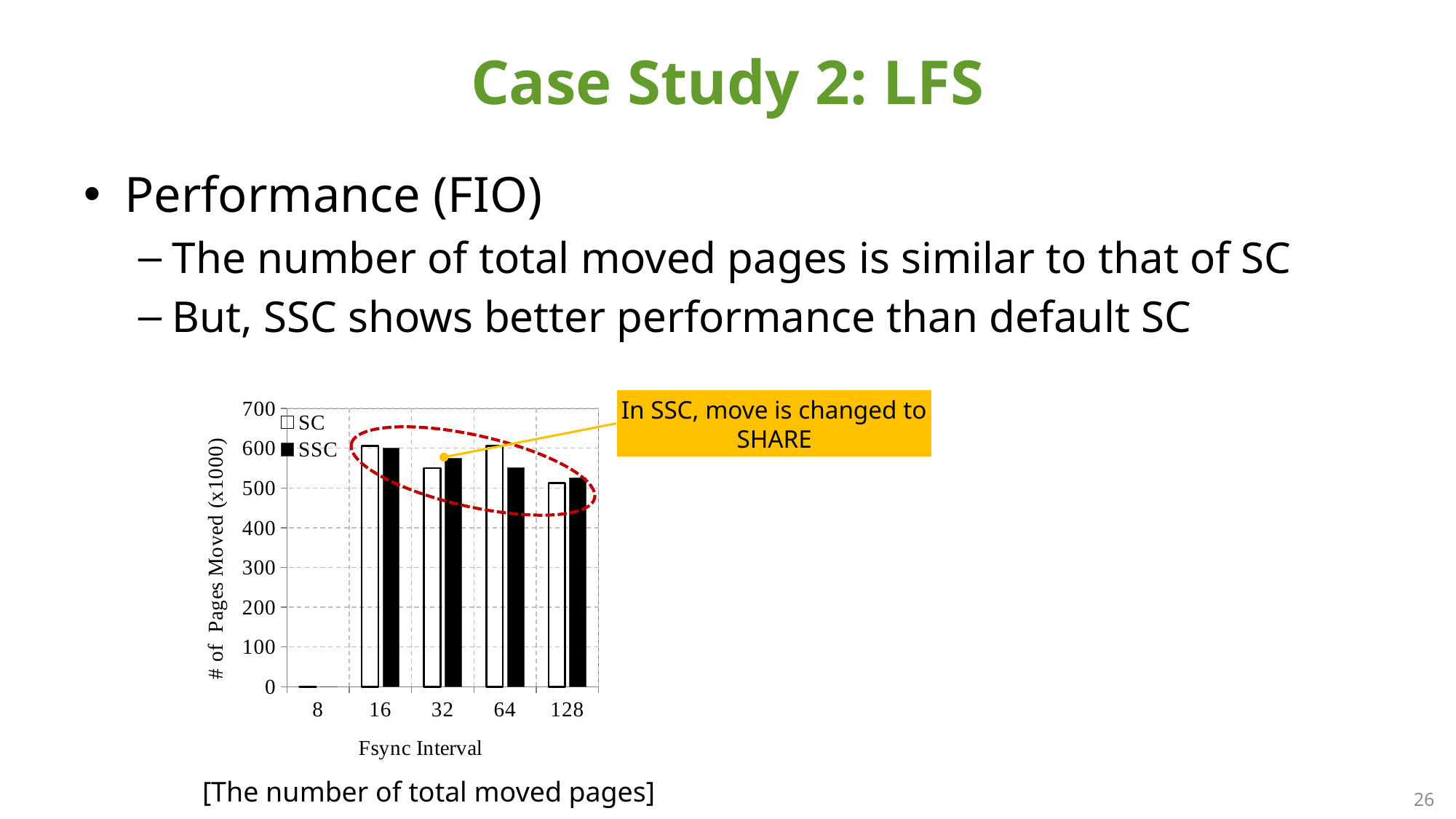
What are the two series named in the chart's legend? SC and SSC Which Fsync Interval has the lowest number of pages moved? 8 How many Fsync Interval categories are shown on the x axis? 5 Is the SC value at Fsync Interval 32 greater or less than 600? less Is the SC value at Fsync Interval 128 greater or less than 600? less What kind of chart is shown on the slide? bar chart What is the label of the chart's y axis? # of Pages Moved (x1000) At Fsync Interval 32, which series has the larger value, SC or SSC? SSC At Fsync Interval 64, which series has the larger value, SC or SSC? SC How many series does the chart's legend list? 2 Is the SSC value at Fsync Interval 64 greater or less than 500? greater